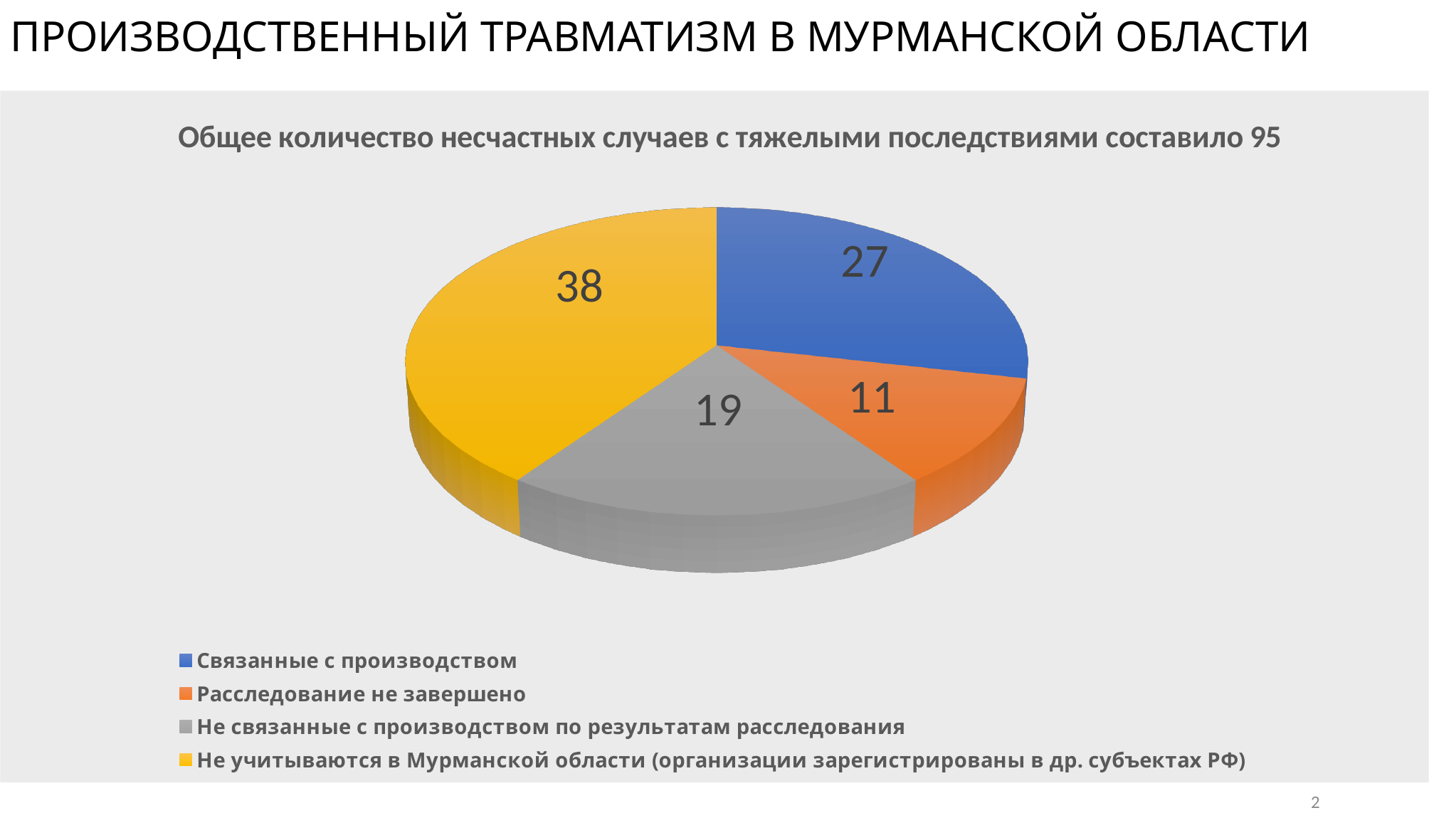
Which category has the largest slice of the pie? Не учитываются в Мурманской области (организации зарегистрированы в др. субъектах РФ) How many slices does the pie chart have? 4 What is the value for "Не учитываются в Мурманской области (организации зарегистрированы в др. субъектах РФ)"? 38 What share of the total of 95 does the slice with value 38 represent? 40% Which category has the smallest slice of the pie? Расследование не завершено What is the value for "Связанные с производством"? 27 What is the difference between the values for "Не учитываются в Мурманской области" and "Связанные с производством"? 11 What colour is the slice for "Расследование не завершено"? Orange What is the value for "Не связанные с производством по результатам расследования"? 19 What is the value for "Расследование не завершено"? 11 Which is larger: "Связанные с производством" or "Не связанные с производством по результатам расследования"? Связанные с производством What kind of chart is shown on the slide? Pie chart